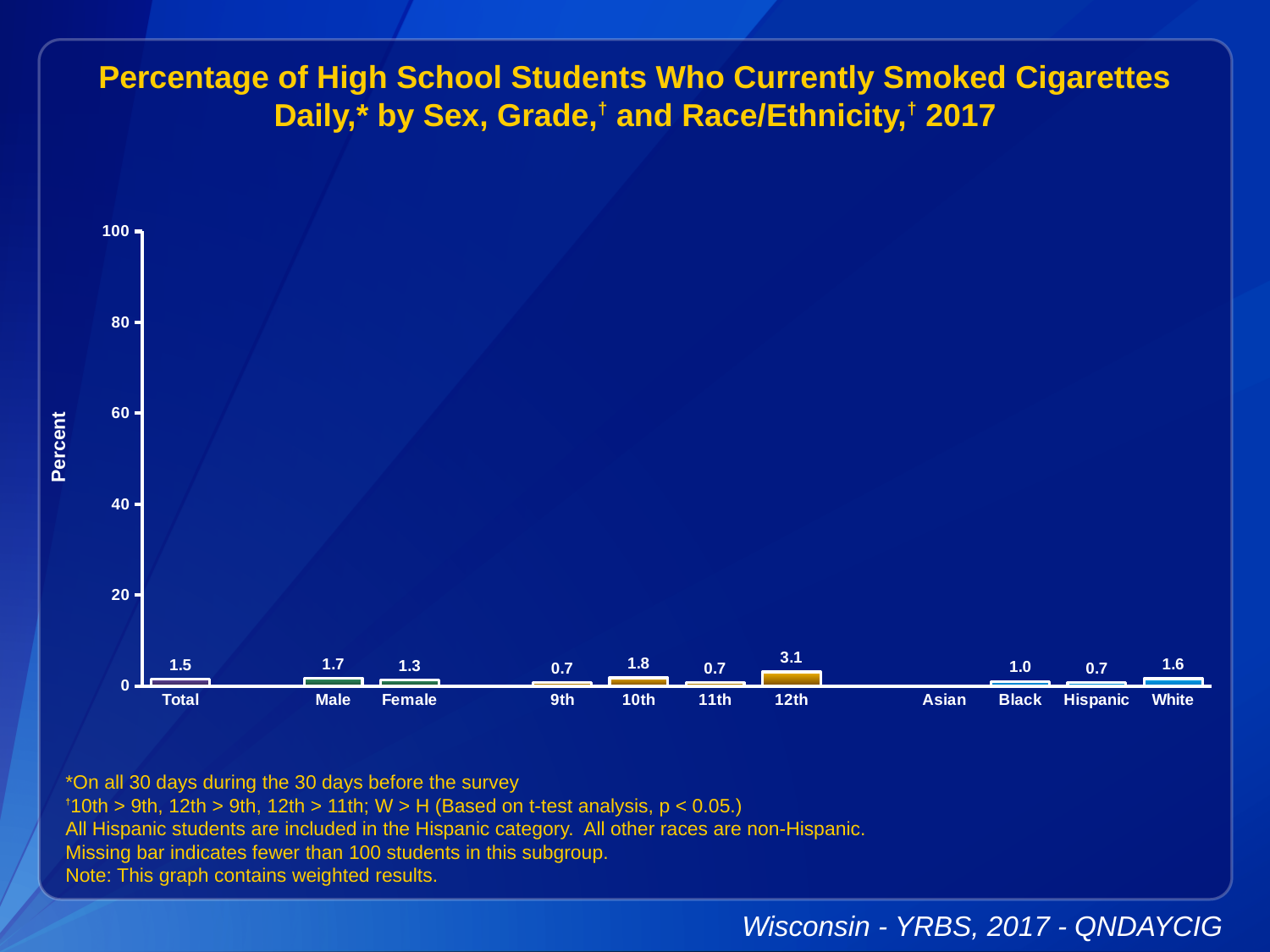
What is the value for 12th grade? 3.1 What is the difference between the values for 12th and 9th grade? 2.4 What is the value for Hispanic students? 0.7 Which is larger, the value for White or the value for Black? White Is the value for 12th grade greater or less than 20? less Which is larger, the value for Male or the value for Female? Male What is the difference between the values for Male and Female? 0.4 Which category on the x axis has no bar plotted? Asian What is the value for Total? 1.5 What kind of chart is shown on the slide? bar chart What is the value for Female? 1.3 Which category has the highest value? 12th